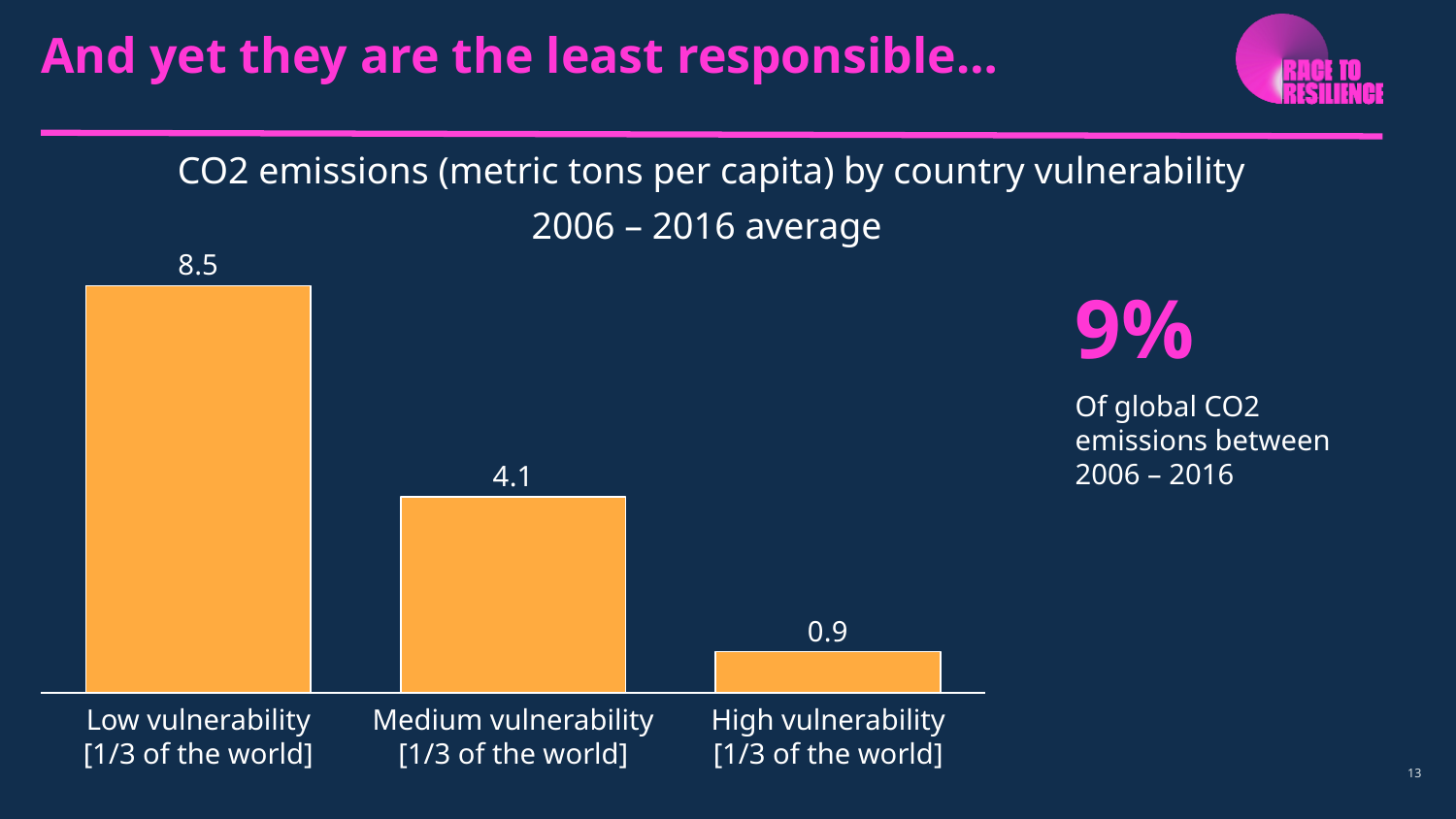
Which category has the lowest CO2 emissions per capita? High vulnerability [1/3 of the world] What is the title of the chart? CO2 emissions (metric tons per capita) by country vulnerability 2006 – 2016 average What is the difference between the values for Low vulnerability and Medium vulnerability? 4.4 Do the values rise or fall from Low vulnerability to High vulnerability along the x axis? Fall What is the value for High vulnerability [1/3 of the world]? 0.9 Which category has the highest CO2 emissions per capita? Low vulnerability [1/3 of the world] What is the value for Low vulnerability [1/3 of the world]? 8.5 What kind of chart is shown on the slide? Bar chart What is the difference between the values for Medium vulnerability and High vulnerability? 3.2 What is the value for Medium vulnerability [1/3 of the world]? 4.1 Which is larger, the value for Medium vulnerability or the value for High vulnerability? Medium vulnerability How many categories are shown in the chart? 3